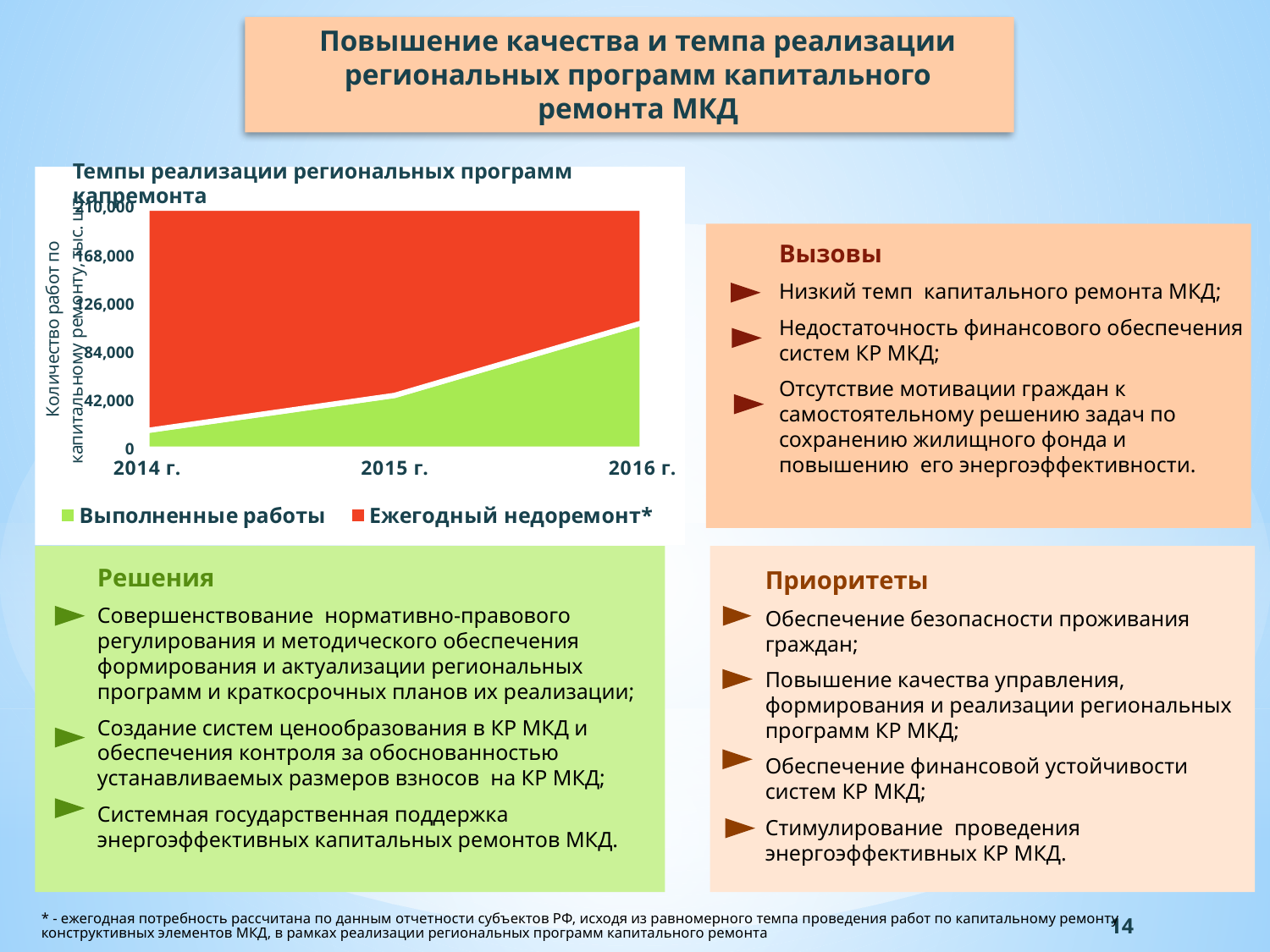
Which is larger: Выполненные работы in 2016 г. or in 2014 г.? 2016 г. In which year is the value of Выполненные работы lowest? 2014 г. What kind of chart is shown on the slide? area chart How many series does the chart legend list? 2 How many years are shown on the x axis of the chart? 3 Does the value of Выполненные работы rise or fall from 2014 г. to 2016 г.? rise Does the value of Ежегодный недоремонт* rise or fall from 2014 г. to 2016 г.? fall Is the value of Выполненные работы in 2014 г. greater or less than 42,000? less What is the title of the chart? Темпы реализации региональных программ капремонта Which series is shown in green in the chart? Выполненные работы Is the value of Выполненные работы in 2016 г. greater or less than 84,000? greater In which year is the value of Выполненные работы highest? 2016 г.